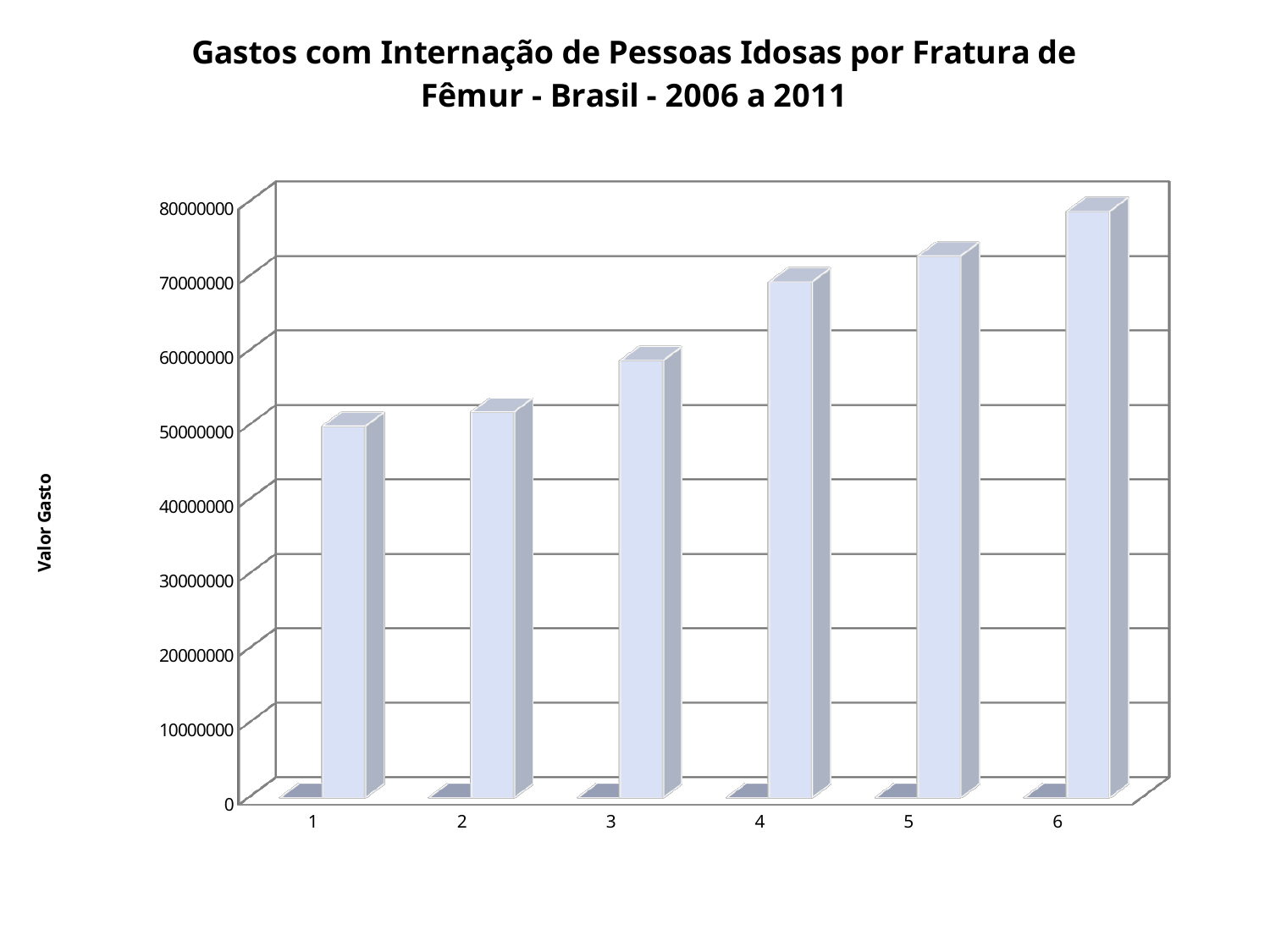
Which has the larger value, category 3 or category 4? 4 Which category has the highest value? 6 Is the value for category 2 greater or less than 50000000? greater Is the value for category 6 greater or less than 80000000? less What is the label of the vertical axis? Valor Gasto Which category has the lowest value? 1 Is the value for category 4 greater or less than 60000000? greater How many bars (categories) are plotted in the chart? 6 What kind of chart is shown on the slide? bar chart Do the values rise or fall from category 1 to category 6? rise